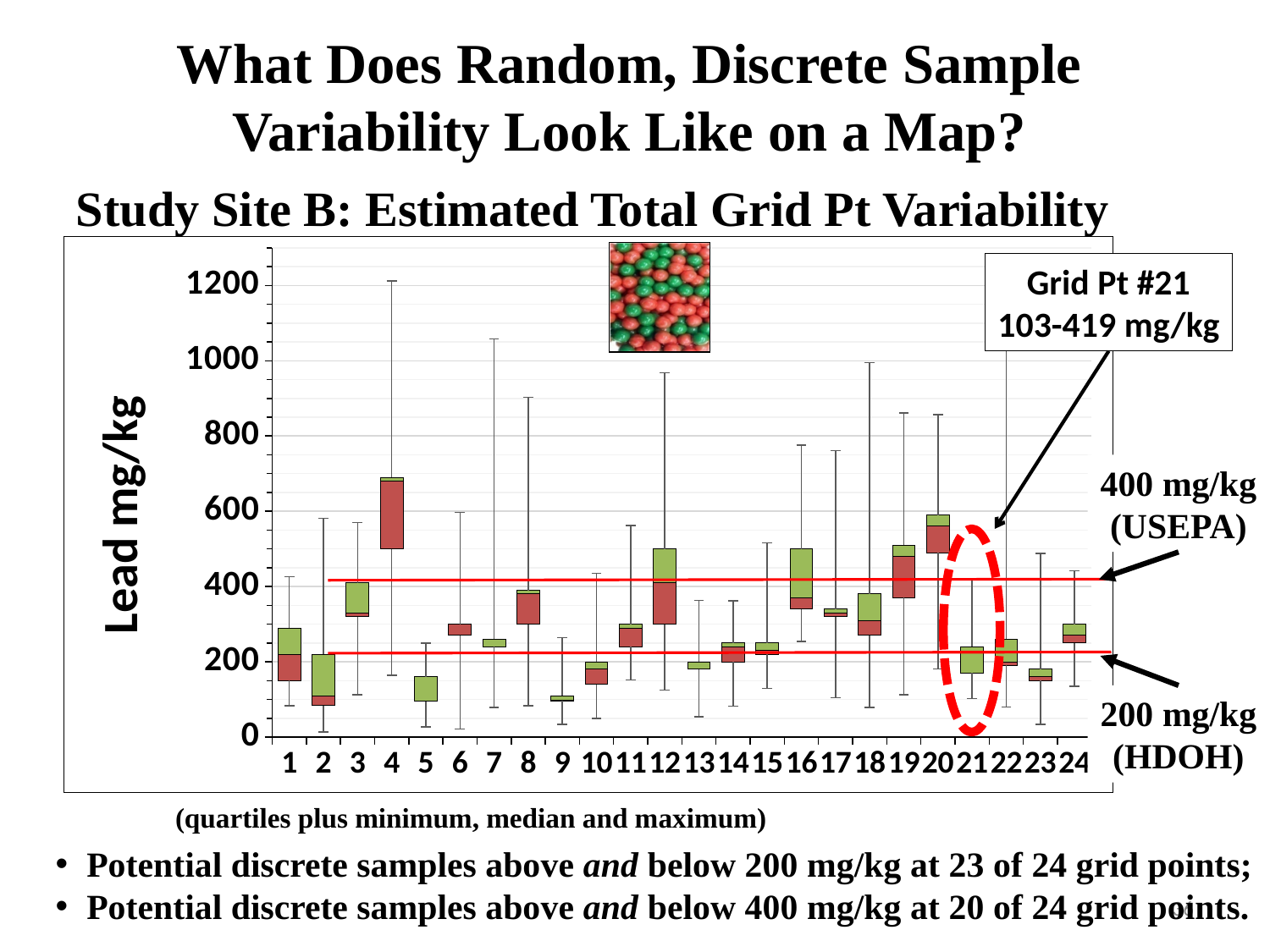
What lead concentration does the upper red horizontal reference line (USEPA) represent? 400 mg/kg Which grid point has a higher maximum value, grid point 4 or grid point 16? 4 How many grid points are plotted along the x axis? 24 What range of lead concentrations is annotated for Grid Pt #21? 103-419 mg/kg What kind of chart is shown on the slide? Box-and-whisker (box plot) chart Is the maximum value for grid point 12 greater or less than 800? greater Is the top of the box for grid point 4 greater or less than 600? greater Is the top of the box for grid point 5 greater or less than 200? less What is the label of the y axis? Lead mg/kg What lead concentration does the lower red horizontal reference line (HDOH) represent? 200 mg/kg Which grid point has the highest maximum (top of the upper whisker)? 4